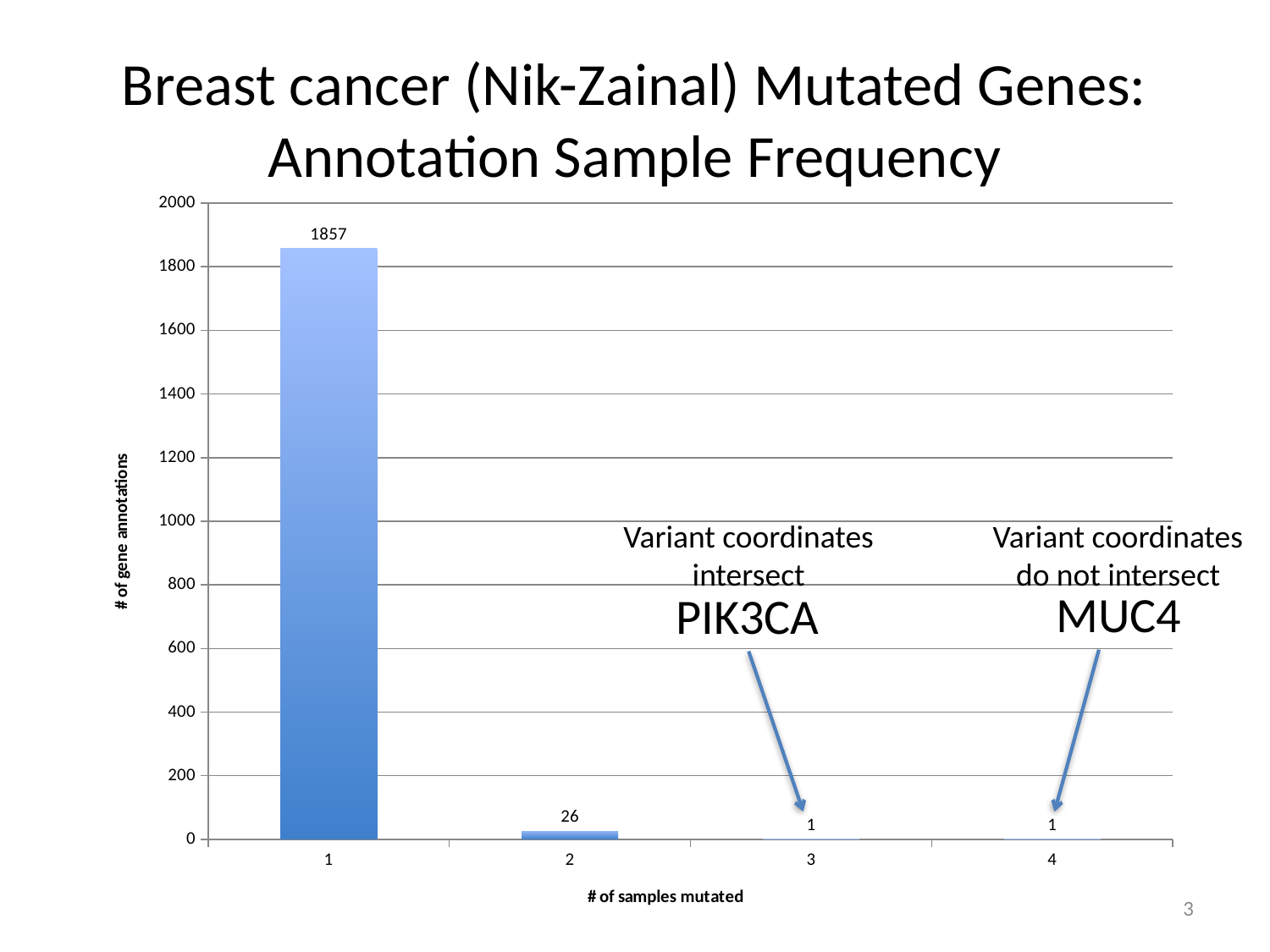
What is the number of gene annotations for 1 sample mutated? 1857 Which gene is annotated as having variant coordinates that do not intersect? MUC4 Do the values rise or fall as the number of samples mutated increases along the x axis? fall What is the number of gene annotations for 3 samples mutated? 1 What is the number of gene annotations for 2 samples mutated? 26 Is the value for 1 sample mutated greater or less than 1800? greater Which category on the x axis has the highest number of gene annotations? 1 What kind of chart is shown on the slide? bar chart How many categories are shown on the x axis? 4 Which has more gene annotations: 2 samples mutated or 3 samples mutated? 2 What is the label of the y axis? # of gene annotations What is the difference in gene annotations between 1 sample mutated and 2 samples mutated? 1831